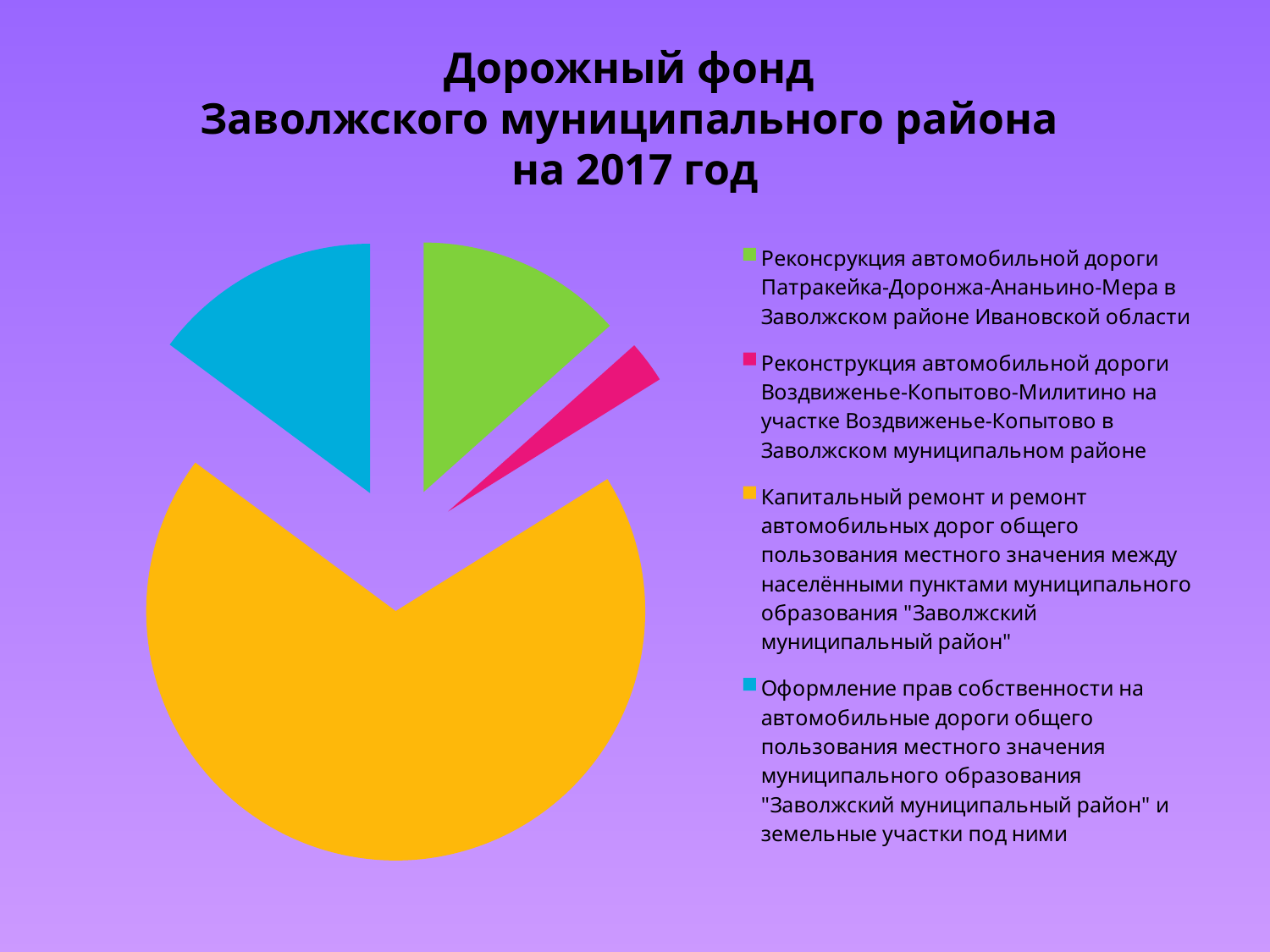
Which slice is larger: the one for "Реконсрукция автомобильной дороги Патракейка-Доронжа-Ананьино-Мера" or the one for "Реконструкция автомобильной дороги Воздвиженье-Копытово-Милитино"? Реконсрукция автомобильной дороги Патракейка-Доронжа-Ананьино-Мера Which slice is larger: "Капитальный ремонт и ремонт автомобильных дорог общего пользования" or "Оформление прав собственности на автомобильные дороги"? Капитальный ремонт и ремонт автомобильных дорог общего пользования How many entries does the legend of the pie chart list? 4 Does the largest slice of the pie chart take up more or less than half of the pie? more How many slices does the pie chart have? 4 Which category has the smallest slice of the pie chart? Реконструкция автомобильной дороги Воздвиженье-Копытово-Милитино на участке Воздвиженье-Копытово в Заволжском муниципальном районе What is the title of the chart on the slide? Дорожный фонд Заволжского муниципального района на 2017 год Which category has the largest slice of the pie chart? Капитальный ремонт и ремонт автомобильных дорог общего пользования местного значения между населёнными пунктами муниципального образования "Заволжский муниципальный район" What kind of chart is shown on the slide? pie chart What colour is the slice for "Оформление прав собственности на автомобильные дороги общего пользования местного значения"? blue